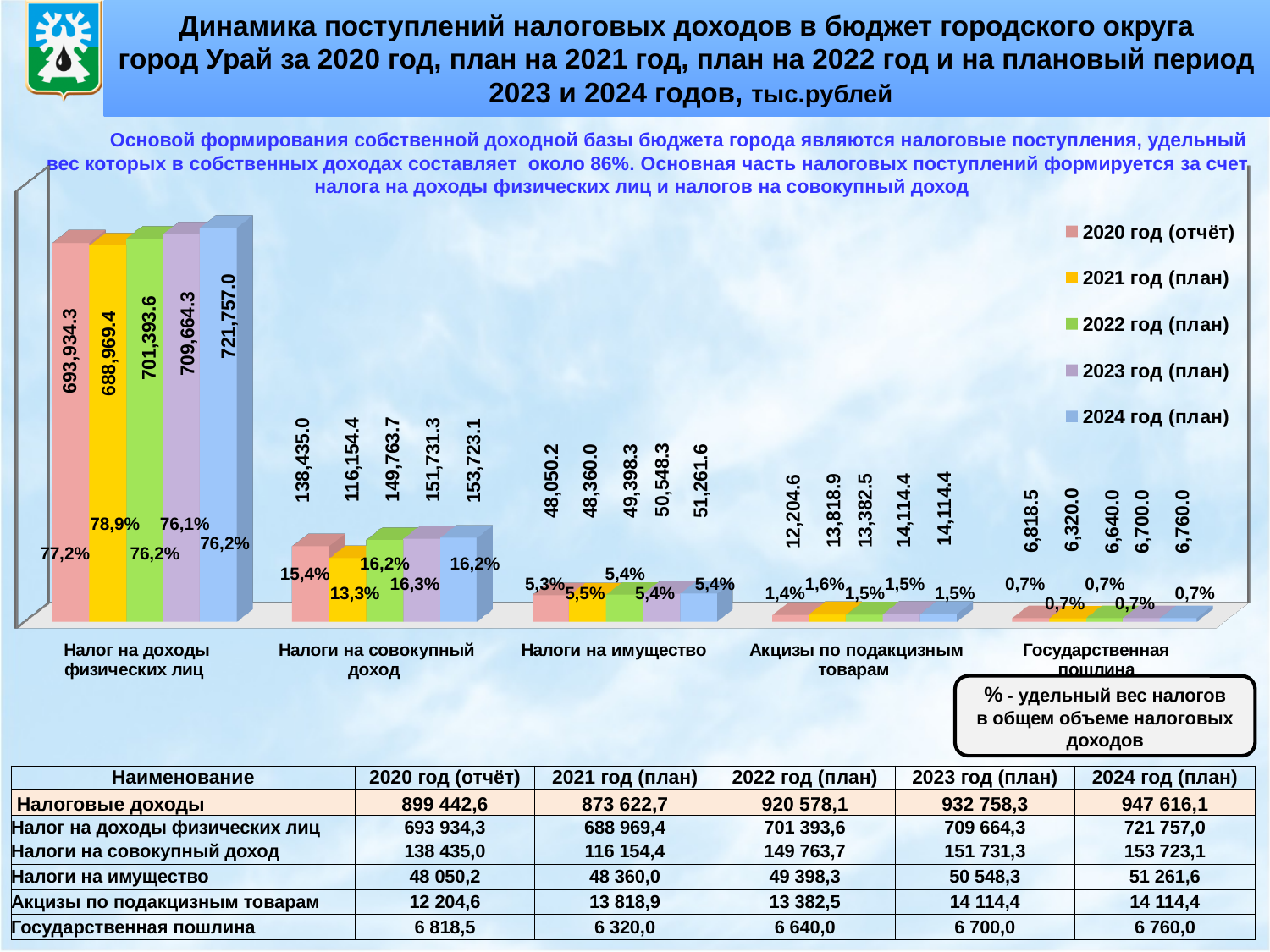
For Налоги на имущество, which is larger: the 2021 год (план) value or the 2022 год (план) value? 2022 год (план) What is the value for Налог на доходы физических лиц in the 2024 год (план) series? 721,757.0 How many tax categories are plotted along the x axis of the chart? 5 What percentage label is shown for Налог на доходы физических лиц in the 2020 год (отчёт) series? 77,2% Which category has the highest value in the 2020 год (отчёт) series? Налог на доходы физических лиц What kind of chart is shown on the slide? bar chart Do the values for Налоги на имущество rise or fall from the 2020 series to the 2024 series? rise What is the difference between the 2024 год (план) and 2020 год (отчёт) values for Налог на доходы физических лиц? 27,822.7 What is the value for Налоги на совокупный доход in the 2021 год (план) series? 116,154.4 How many series does the chart legend list? 5 According to the note on the slide, what do the percentage labels on the chart represent? удельный вес налогов в общем объеме налоговых доходов Which category has the lowest value in the 2024 год (план) series? Государственная пошлина